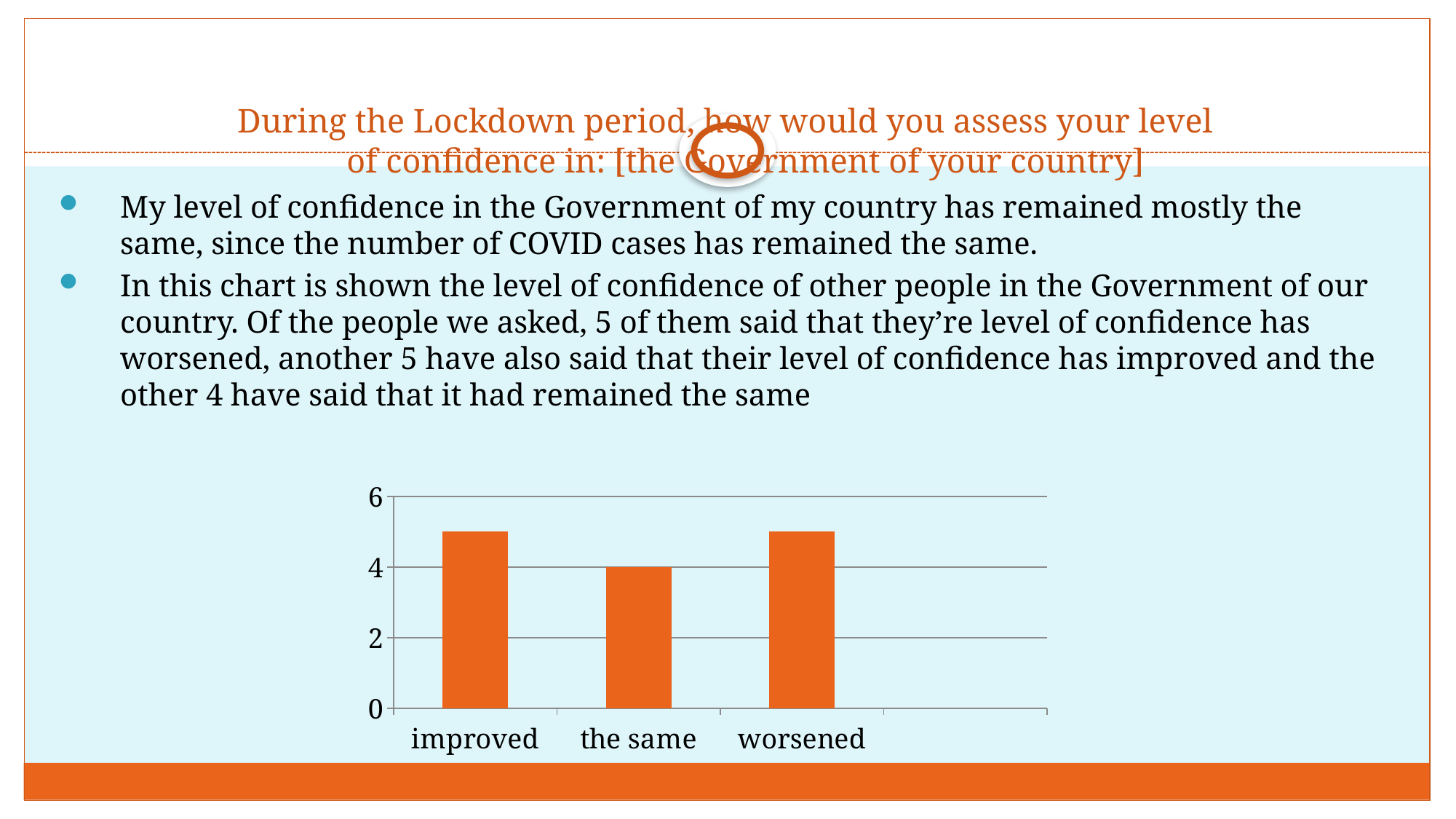
Is the value for "improved" greater or less than 4? greater Is the value for "worsened" greater or less than 6? less What colour are the bars in the chart? orange How many categories are shown on the x axis of the chart? 3 What is the highest tick value shown on the vertical axis of the chart? 6 What is the difference between the value for "worsened" and the value for "the same"? 1 What kind of chart is shown on the slide? bar chart Which category has the lowest bar in the chart? the same What is the value for "improved" in the chart? 5 Which is larger, the value for "improved" or the value for "the same"? improved What is the value for "the same" in the chart? 4 What is the value for "worsened" in the chart? 5